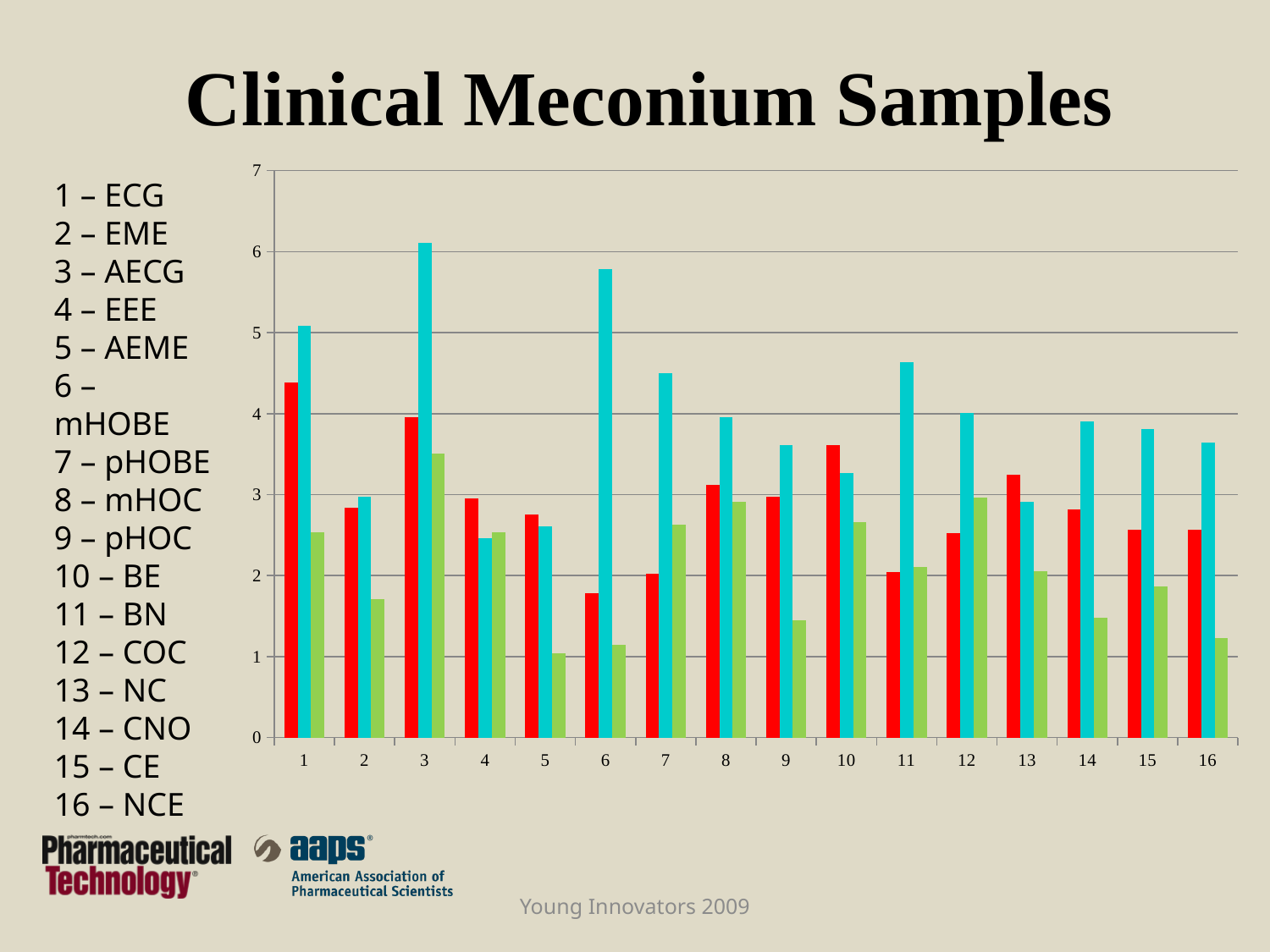
For category 1, which bar is taller, the red bar or the green bar? red Is the red bar for category 1 greater or less than 4? greater What is the title of the slide containing the chart? Clinical Meconium Samples For which category does the cyan bar reach its highest value? 3 According to the key on the left, what compound does category 12 on the x axis represent? COC How many numbered categories are shown along the x axis of the chart? 16 Is the cyan bar for category 3 greater or less than 6? greater What kind of chart is shown on the slide? bar chart For which category is the red bar the lowest? 6 Is the green bar for category 5 greater or less than 2? less For category 6, which bar is taller, the red bar or the cyan bar? cyan For which category does the red bar reach its highest value? 1